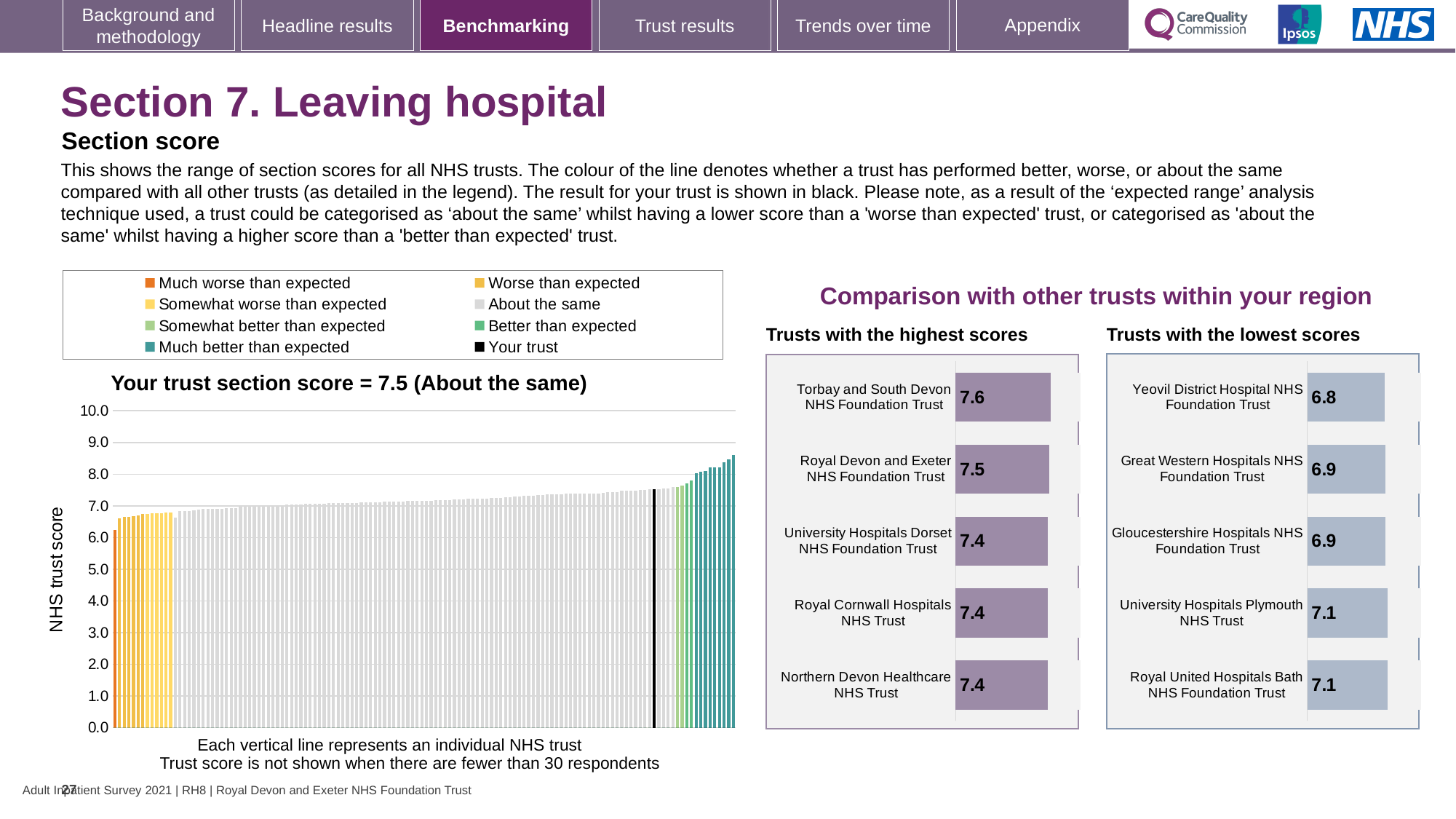
In the 'Trusts with the lowest scores' chart, what is the score for Yeovil District Hospital NHS Foundation Trust? 6.8 Which has the larger score: Royal Devon and Exeter NHS Foundation Trust in the highest-scores chart or Great Western Hospitals NHS Foundation Trust in the lowest-scores chart? Royal Devon and Exeter NHS Foundation Trust In the 'Trusts with the highest scores' chart, which trust has the highest score? Torbay and South Devon NHS Foundation Trust In the 'Trusts with the highest scores' chart, what is the score for Torbay and South Devon NHS Foundation Trust? 7.6 How many trusts are listed in the 'Trusts with the highest scores' chart? 5 In the 'Trusts with the highest scores' chart, what is the difference between the scores of Torbay and South Devon NHS Foundation Trust and Northern Devon Healthcare NHS Trust? 0.2 What kind of chart is the main 'Your trust section score' chart? Bar chart In the 'Trusts with the lowest scores' chart, which trust has the lowest score? Yeovil District Hospital NHS Foundation Trust How many entries does the legend of the main 'Your trust section score' chart list? 8 In the main 'Your trust section score' chart, is the value of the lowest bar greater or less than 7.0? less In the main 'Your trust section score' chart, what is the section score for your trust? 7.5 In the 'Trusts with the lowest scores' chart, what is the difference between the scores of Royal United Hospitals Bath NHS Foundation Trust and Yeovil District Hospital NHS Foundation Trust? 0.3